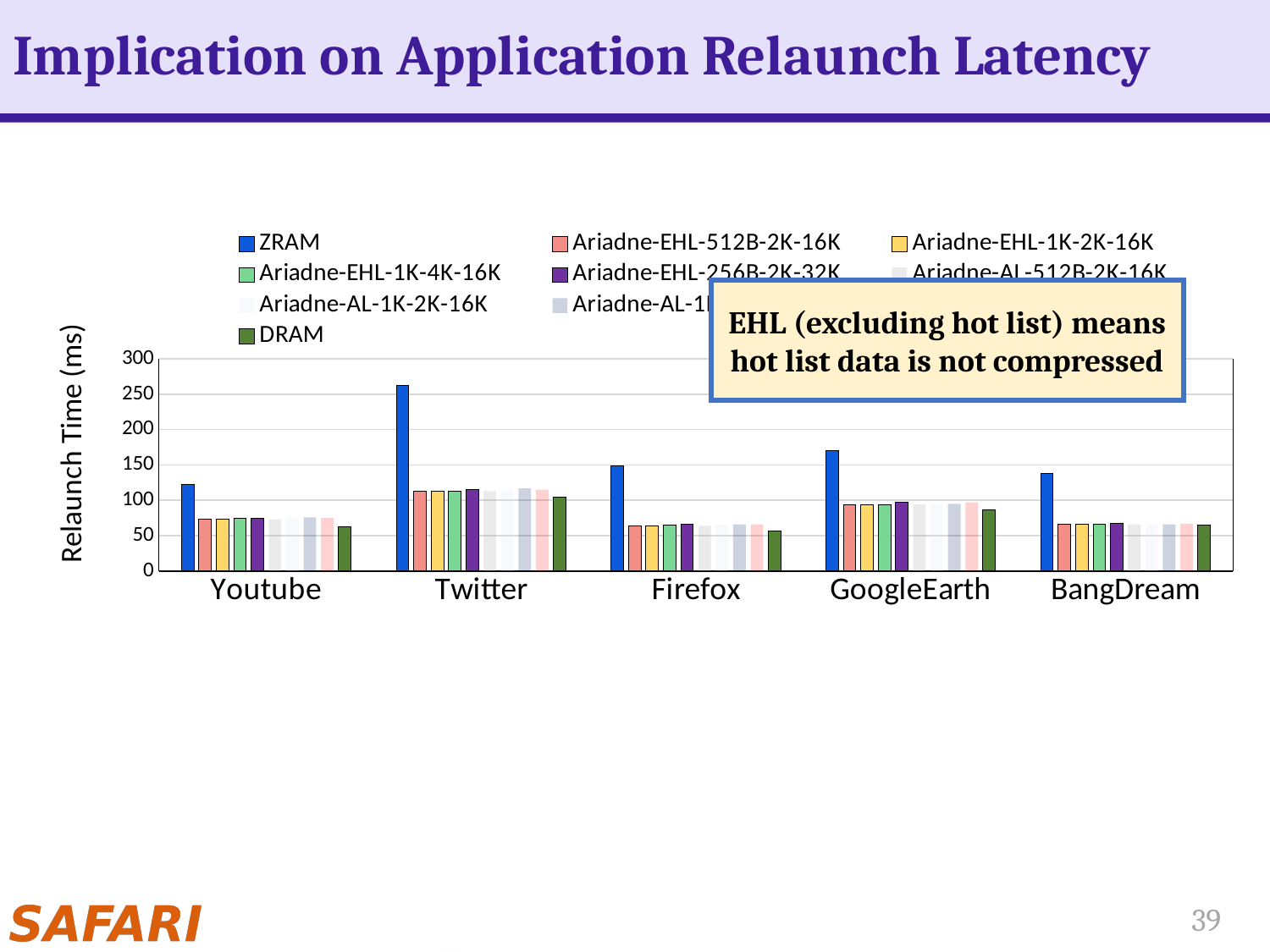
Is the ZRAM relaunch time for Twitter greater or less than 250? greater Which application has the highest ZRAM relaunch time? Twitter How many applications are shown along the x axis of the chart? 5 What kind of chart is shown on the slide? bar chart Which series has the highest relaunch time for Twitter? ZRAM Is the ZRAM relaunch time for Twitter larger or smaller than the ZRAM relaunch time for GoogleEarth? larger Is the ZRAM relaunch time for Youtube greater or less than 100? greater Is the ZRAM relaunch time for GoogleEarth greater or less than 150? greater What is the label of the y axis of the chart? Relaunch Time (ms) Which application has the lowest ZRAM relaunch time? Youtube What is the title of the slide containing the chart? Implication on Application Relaunch Latency